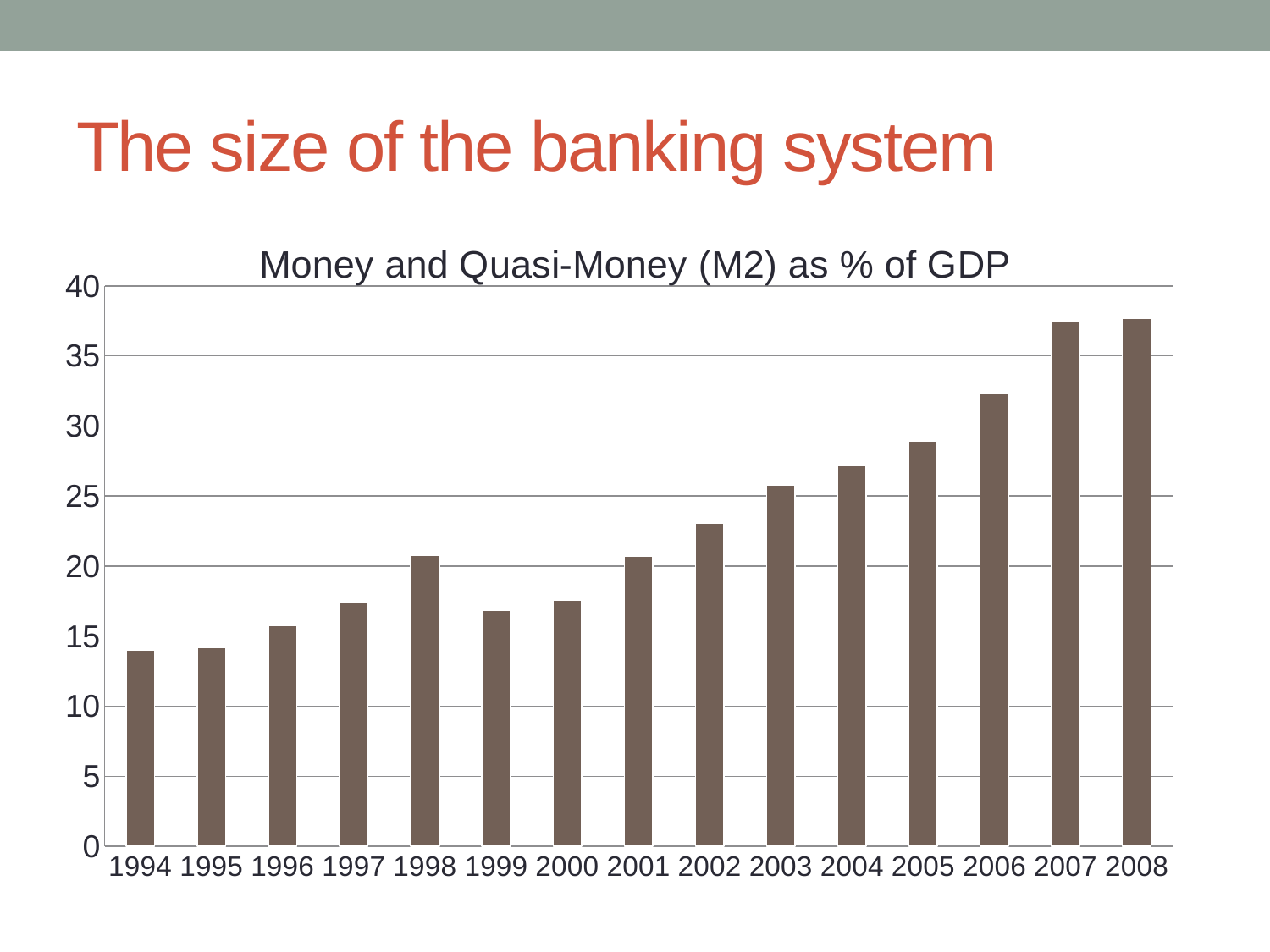
Is the value for 1999 greater or less than 20? less Which year has the larger value, 2005 or 2006? 2006 Is the value for 1994 greater or less than 15? less What is the title of the chart? Money and Quasi-Money (M2) as % of GDP Is the value for 2002 greater or less than 20? greater Overall, do the values rise or fall from 1994 to 2008? rise Which year has the larger value, 1998 or 1999? 1998 How many years are shown on the x axis of the chart? 15 What type of chart is shown on the slide? bar chart